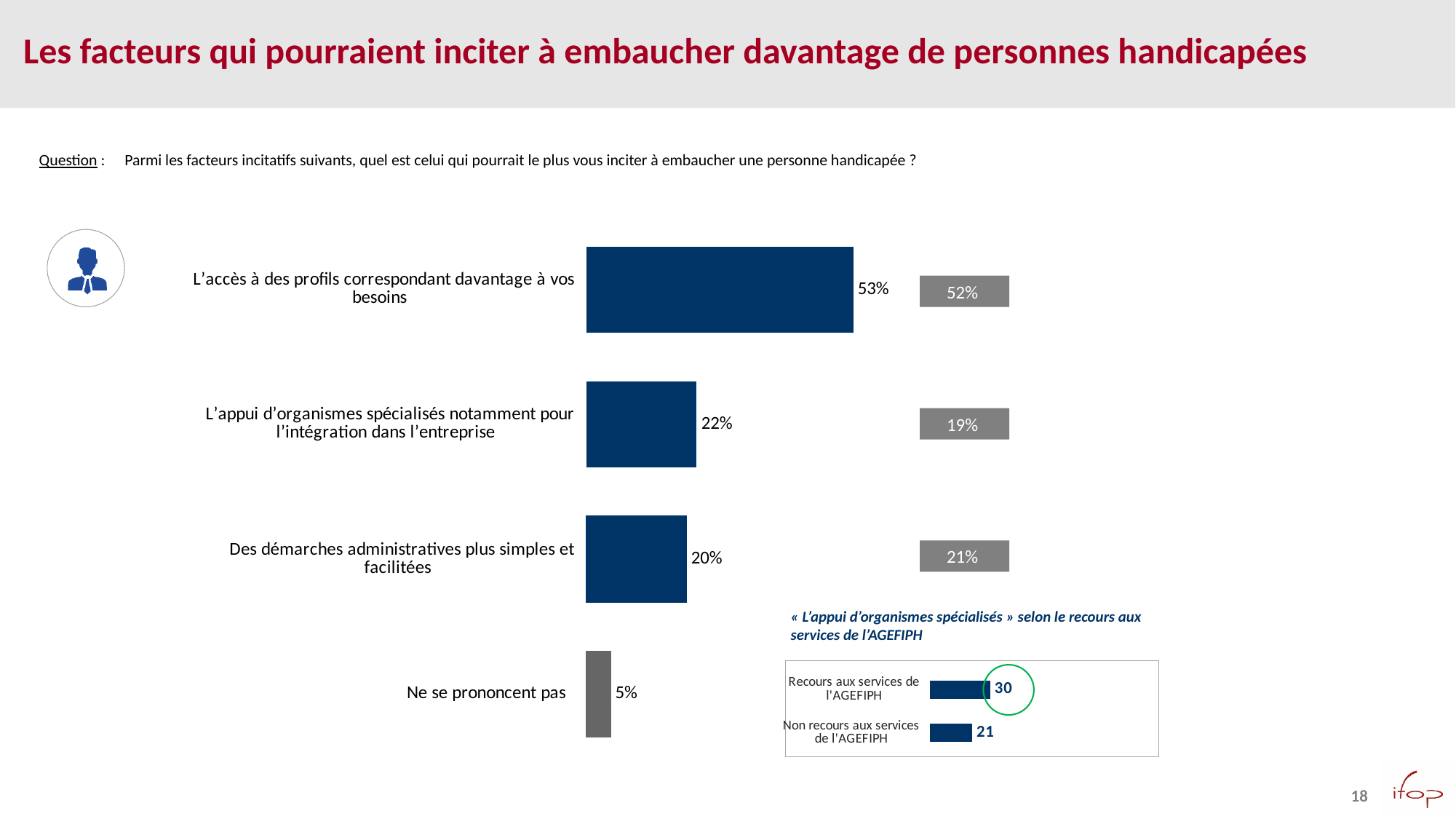
What kind of chart is the main chart on the slide? Bar chart In the main bar chart, how many categories are shown? 4 In the inset chart titled "« L'appui d'organismes spécialisés » selon le recours aux services de l'AGEFIPH", which of the two categories has the larger value? Recours aux services de l'AGEFIPH In the main bar chart, what is the value for "L'appui d'organismes spécialisés notamment pour l'intégration dans l'entreprise"? 22% In the main bar chart, which category has the lowest value? Ne se prononcent pas In the main bar chart, what is the value for "L'accès à des profils correspondant davantage à vos besoins"? 53% In the inset chart titled "« L'appui d'organismes spécialisés » selon le recours aux services de l'AGEFIPH", what is the value for "Recours aux services de l'AGEFIPH"? 30 In the main bar chart, what is the value for "Ne se prononcent pas"? 5% In the main bar chart, what is the difference between the values for "L'accès à des profils correspondant davantage à vos besoins" and "L'appui d'organismes spécialisés notamment pour l'intégration dans l'entreprise"? 31 percentage points In the inset chart titled "« L'appui d'organismes spécialisés » selon le recours aux services de l'AGEFIPH", what is the value for "Non recours aux services de l'AGEFIPH"? 21 In the main bar chart, what is the value for "Des démarches administratives plus simples et facilitées"? 20% In the main bar chart, which category has the highest value? L'accès à des profils correspondant davantage à vos besoins